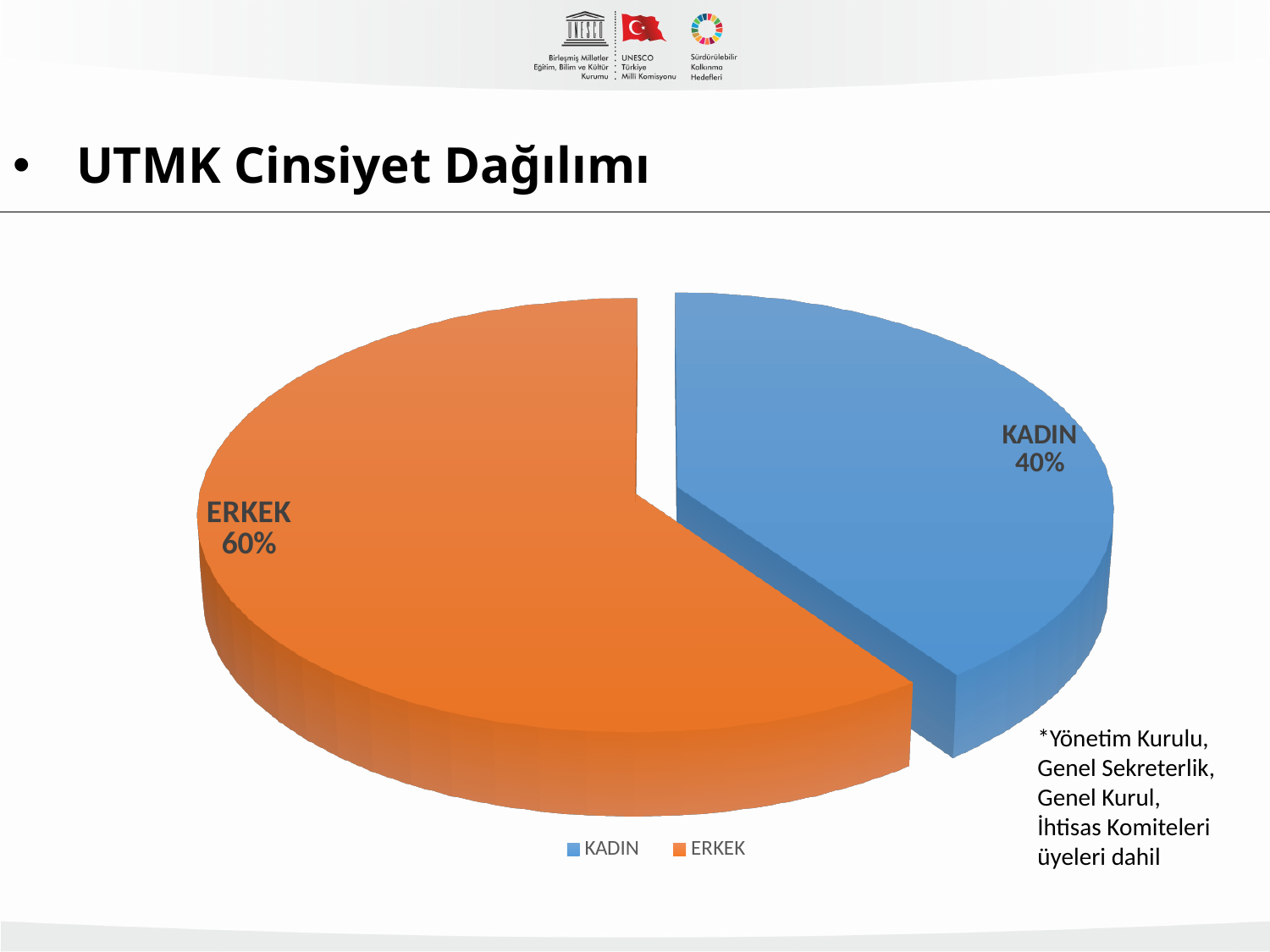
Which is larger, the KADIN slice or the ERKEK slice? ERKEK What is the difference in percentage points between the ERKEK and KADIN slices? 20 How many slices does the pie chart have? 2 What percentage of the pie is labelled KADIN? 40% What is the title of the slide containing the pie chart? UTMK Cinsiyet Dağılımı What kind of chart is shown on the slide? pie chart How many entries does the legend list? 2 Which slice of the pie is the smallest? KADIN Which slice of the pie is the largest? ERKEK What colour is the ERKEK slice in the pie chart? orange What percentage of the pie is labelled ERKEK? 60% What share of the pie does the KADIN slice represent? 40%